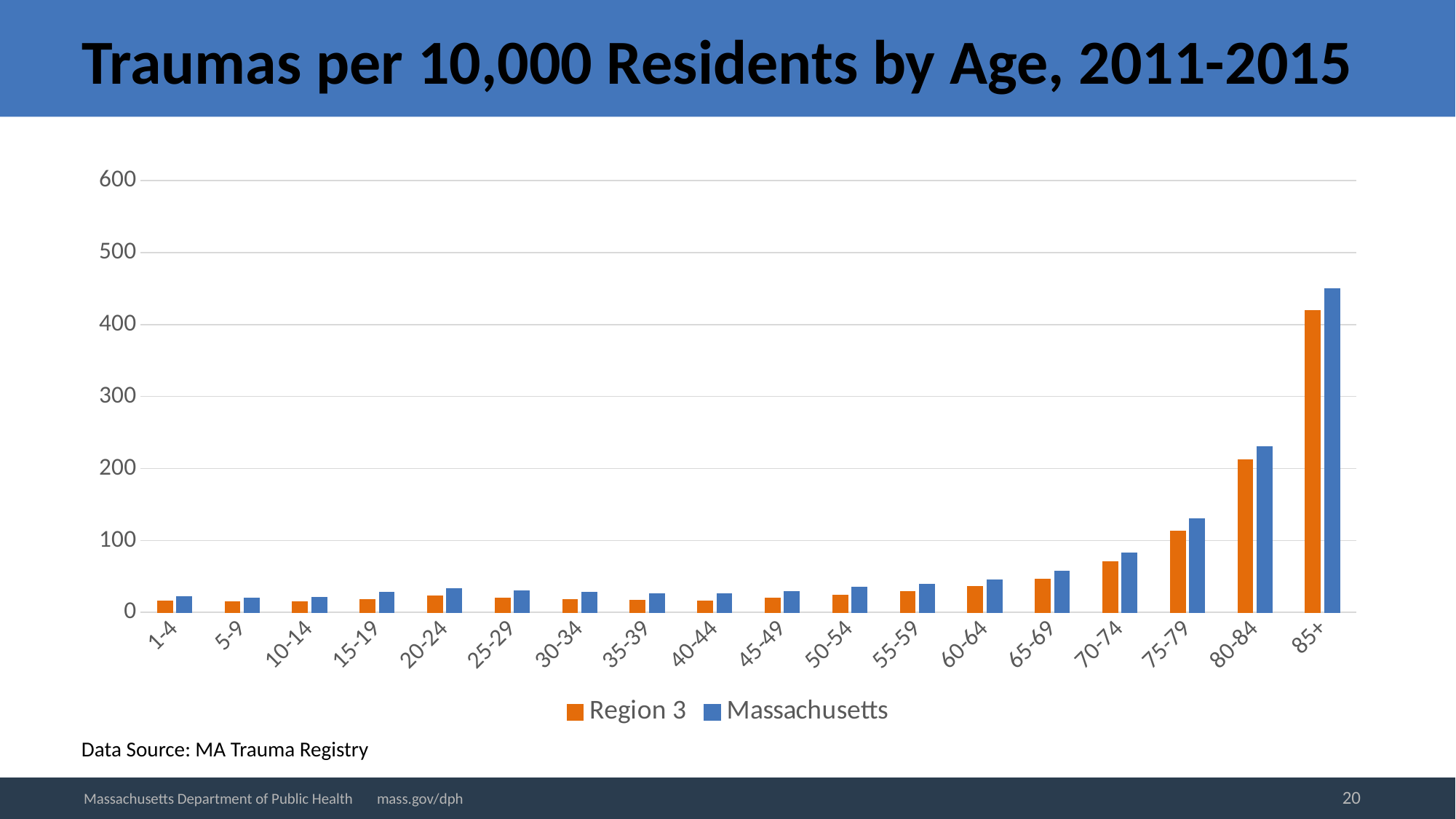
How many series does the legend list? 2 Is the Region 3 value for the 70-74 age group greater or less than 100? less What kind of chart is shown on the slide? bar chart Is the Massachusetts value for the 80-84 age group greater or less than 200? greater How many age groups are shown on the x axis? 18 What is the title of the chart? Traumas per 10,000 Residents by Age, 2011-2015 Which age group has the highest value for Region 3? 85+ Is the Region 3 value for the 80-84 age group greater or less than 300? less For the 85+ age group, which is larger: Region 3 or Massachusetts? Massachusetts Which age group has the highest value for Massachusetts? 85+ Do the values generally rise or fall as age increases from 60-64 to 85+? rise